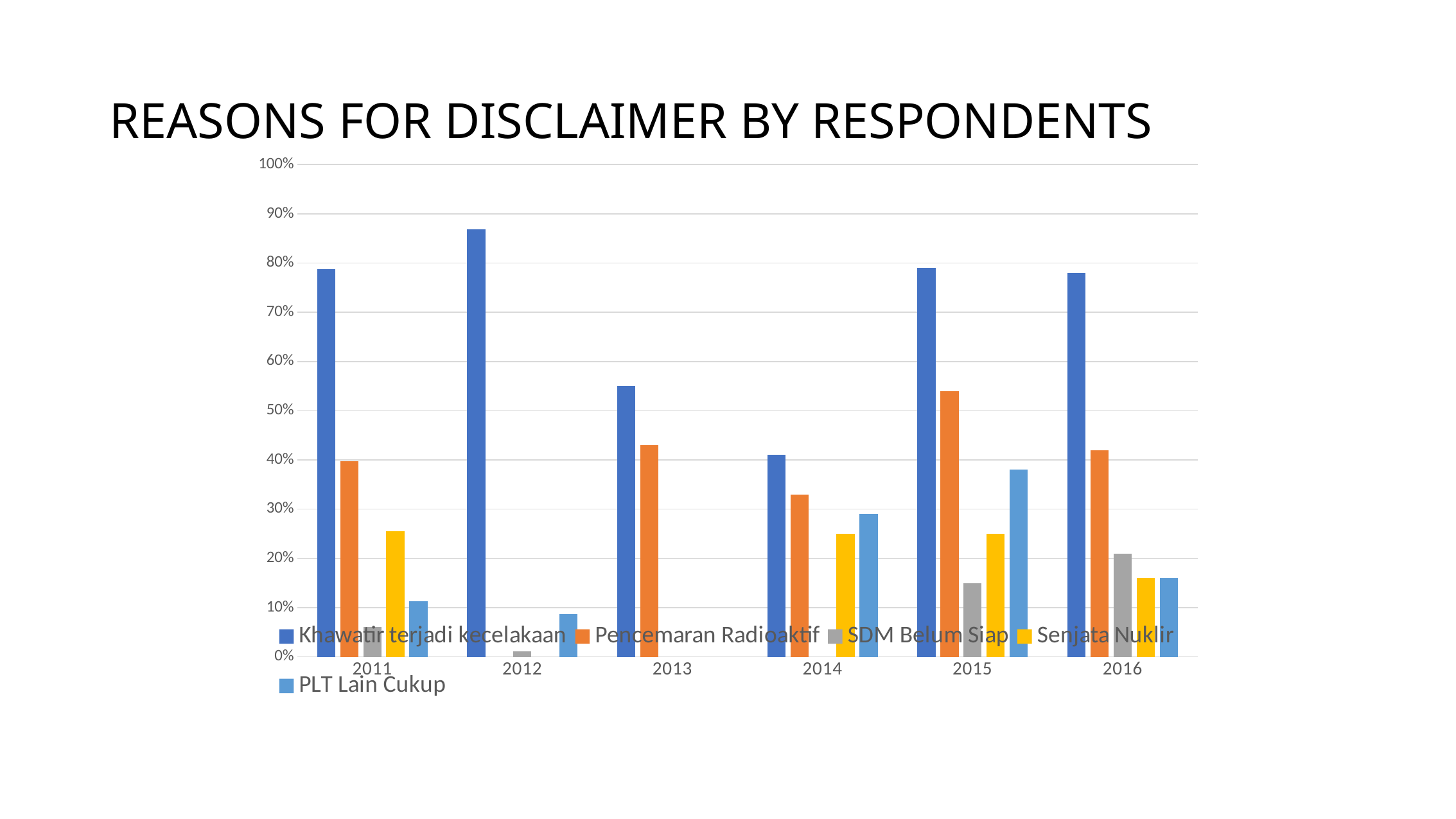
Is the value for Pencemaran Radioaktif in 2015 greater or less than 50%? greater Is the value for Khawatir terjadi kecelakaan in 2012 greater or less than 80%? greater In which year is the bar for Khawatir terjadi kecelakaan the highest? 2012 In 2013, which is larger: Khawatir terjadi kecelakaan or Pencemaran Radioaktif? Khawatir terjadi kecelakaan How many years are shown on the x axis? 6 In which year is the bar for Pencemaran Radioaktif the highest? 2015 In which year is the bar for Khawatir terjadi kecelakaan the lowest? 2014 In 2014, which is larger: PLT Lain Cukup or Senjata Nuklir? PLT Lain Cukup What kind of chart is shown on the slide? bar chart Is the value for Khawatir terjadi kecelakaan in 2013 greater or less than 50%? greater How many series does the legend list? 5 What is the title of the chart? REASONS FOR DISCLAIMER BY RESPONDENTS